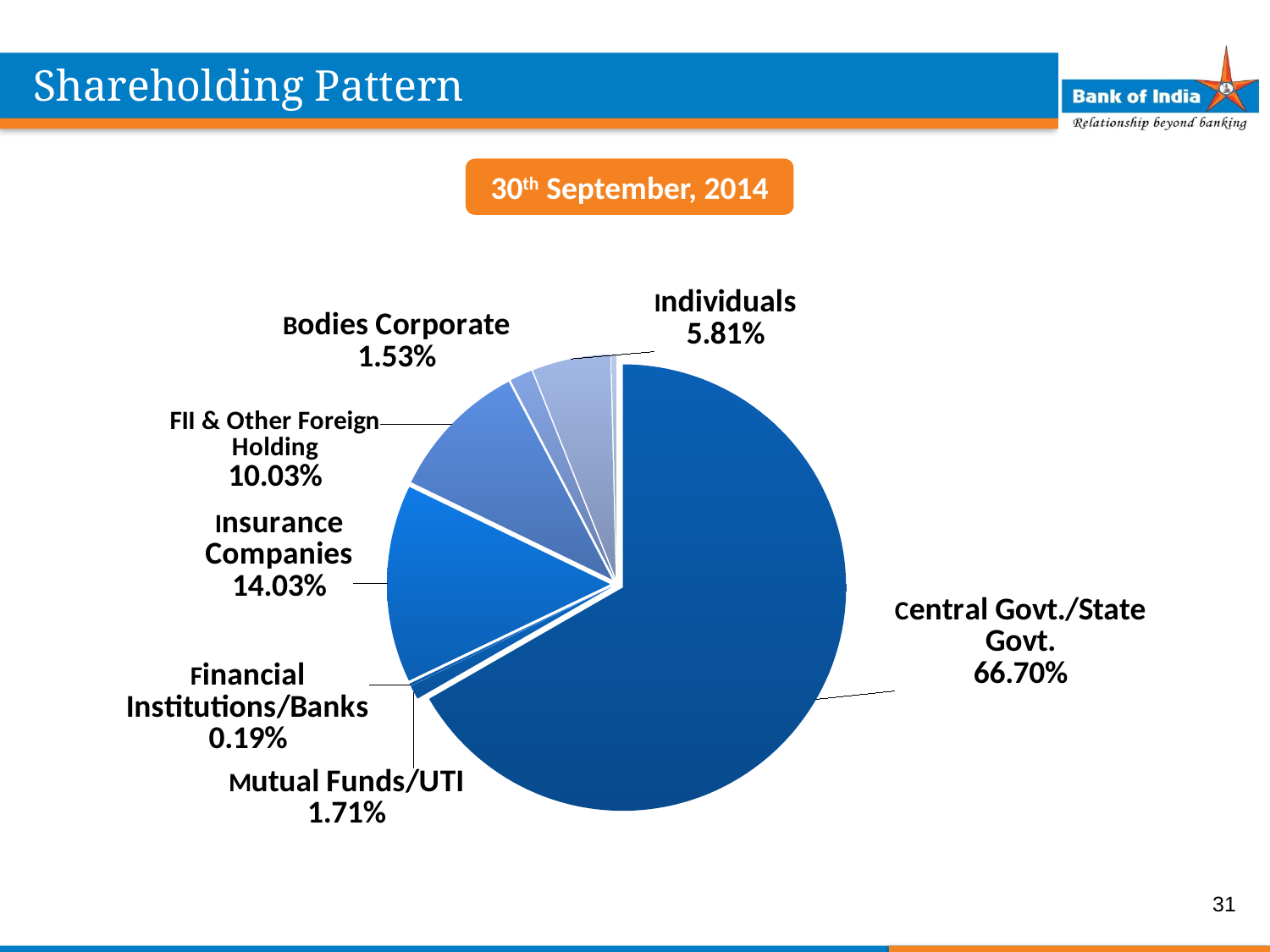
What share of shareholding is held by Individuals? 5.81% What is the difference between the shares of Insurance Companies and FII & Other Foreign Holding? 4.00% What share of shareholding is held by Financial Institutions/Banks? 0.19% What kind of chart is shown on the slide? pie chart What share of shareholding is held by Central Govt./State Govt.? 66.70% What share of shareholding is held by FII & Other Foreign Holding? 10.03% Which shareholder category has the largest share? Central Govt./State Govt. How many shareholder categories are shown in the pie chart? 7 Which is larger, the share of Bodies Corporate or the share of Mutual Funds/UTI? Mutual Funds/UTI What share of shareholding is held by Insurance Companies? 14.03% What share of shareholding is held by Mutual Funds/UTI? 1.71% Which shareholder category has the smallest share? Financial Institutions/Banks